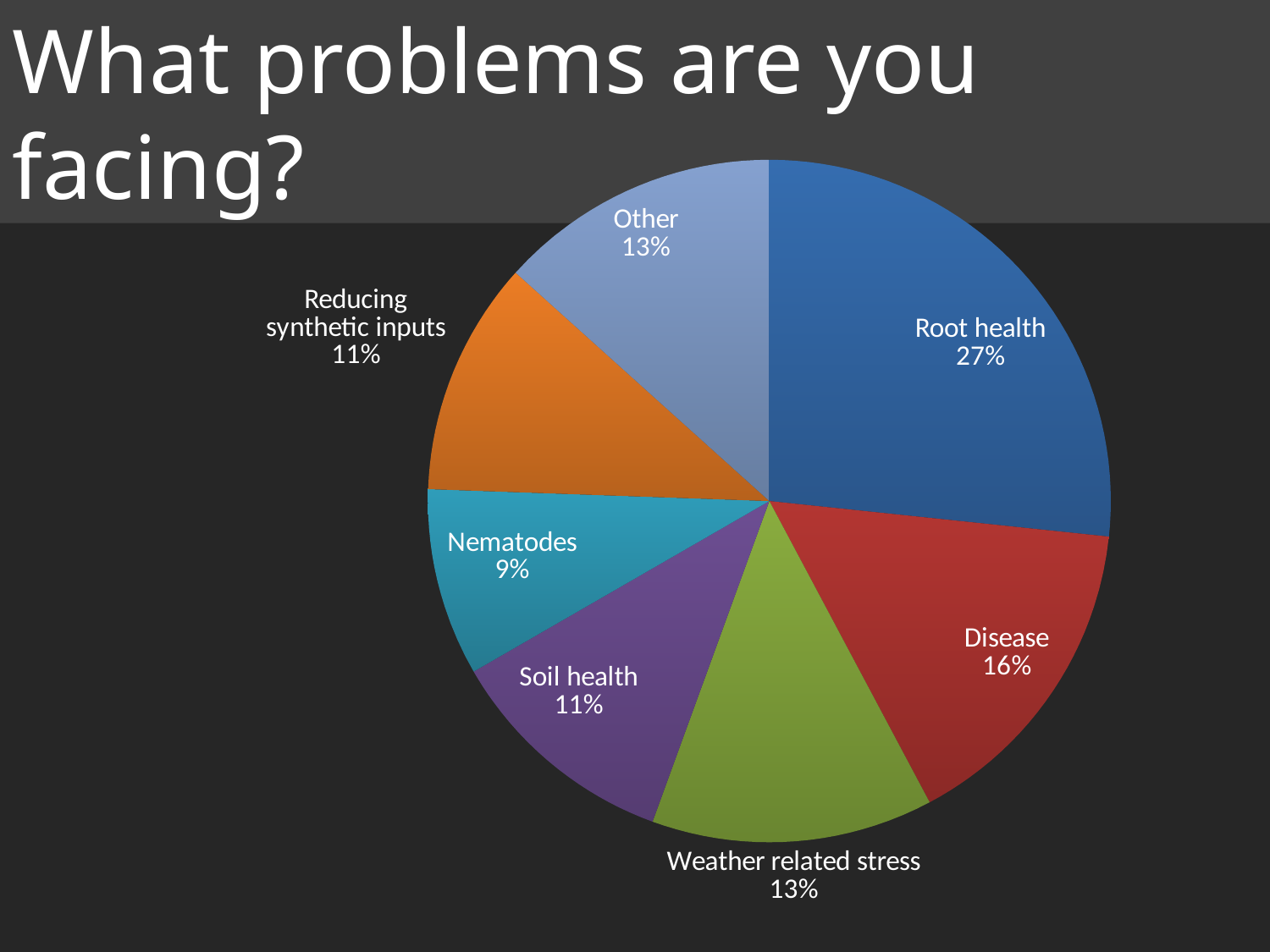
What is the difference in percentage points between Root health and Disease? 11 What is the value shown for Nematodes? 9% What share of the pie does Root health account for? 27% Which is larger, the slice for Weather related stress or the slice for Soil health? Weather related stress How many categories are shown in the pie chart? 7 What is the value shown for Disease? 16% What is the title of the slide containing the chart? What problems are you facing? What kind of chart is shown on the slide? Pie chart What colour is the Root health slice? Blue Which category has the smallest slice of the pie? Nematodes What is the value shown for Reducing synthetic inputs? 11% Which category has the largest slice of the pie? Root health